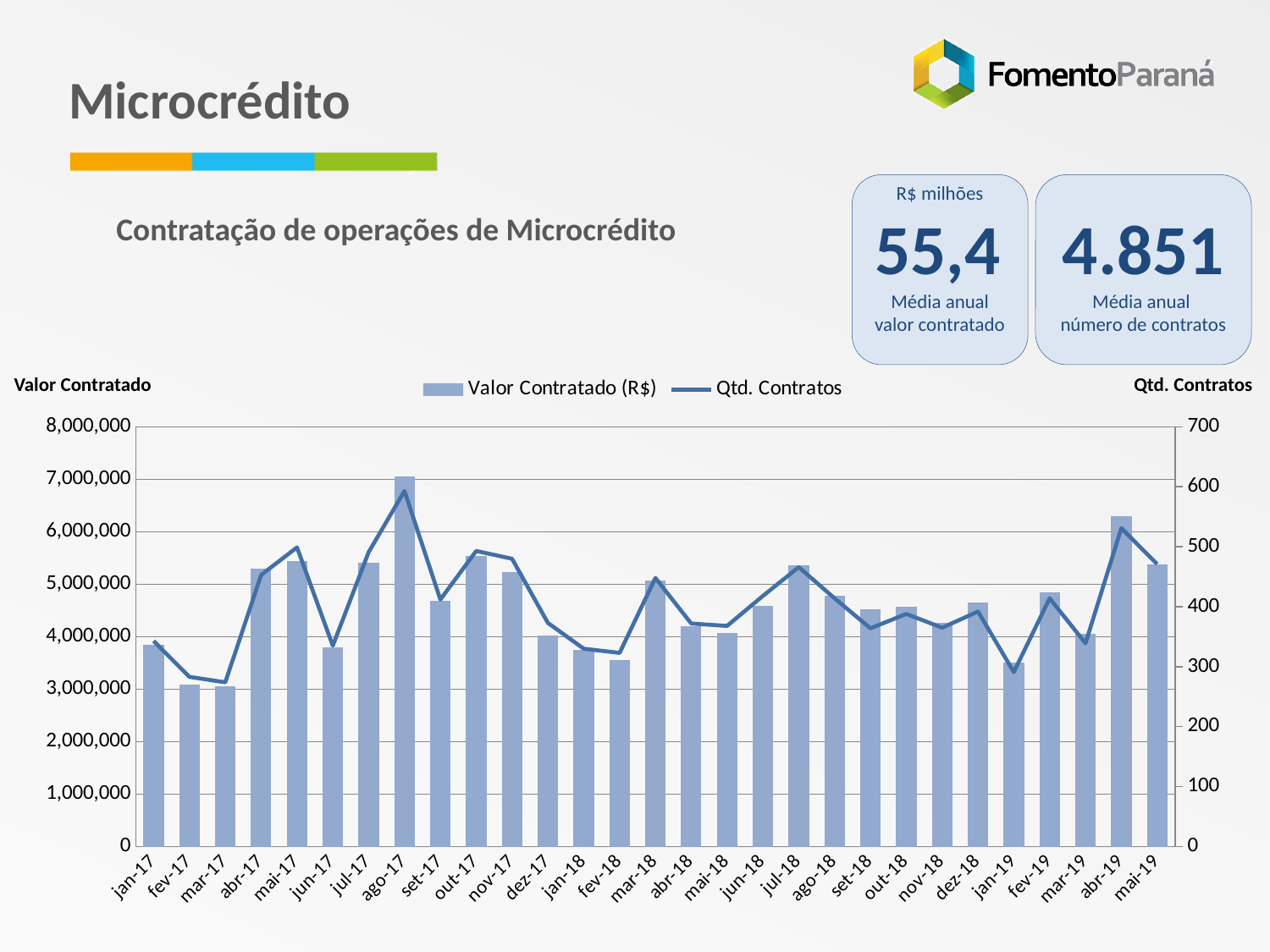
How many series does the chart legend list? 2 How many months are plotted along the x axis of the chart? 29 What kind of chart is shown on the slide? A combination bar and line chart Is the Valor Contratado (R$) for jun-17 greater or less than 4,000,000? less In which month does the Qtd. Contratos line reach its highest point? ago-17 Is the Qtd. Contratos for mar-17 greater or less than 300? less Which month has the highest Valor Contratado (R$) bar? ago-17 Which month has the larger Valor Contratado (R$) bar, abr-19 or mai-19? abr-19 Do the Valor Contratado (R$) bars rise or fall from jan-19 to abr-19? rise Is the Valor Contratado (R$) for abr-19 greater or less than 6,000,000? greater What are the two entries in the chart legend? Valor Contratado (R$) and Qtd. Contratos